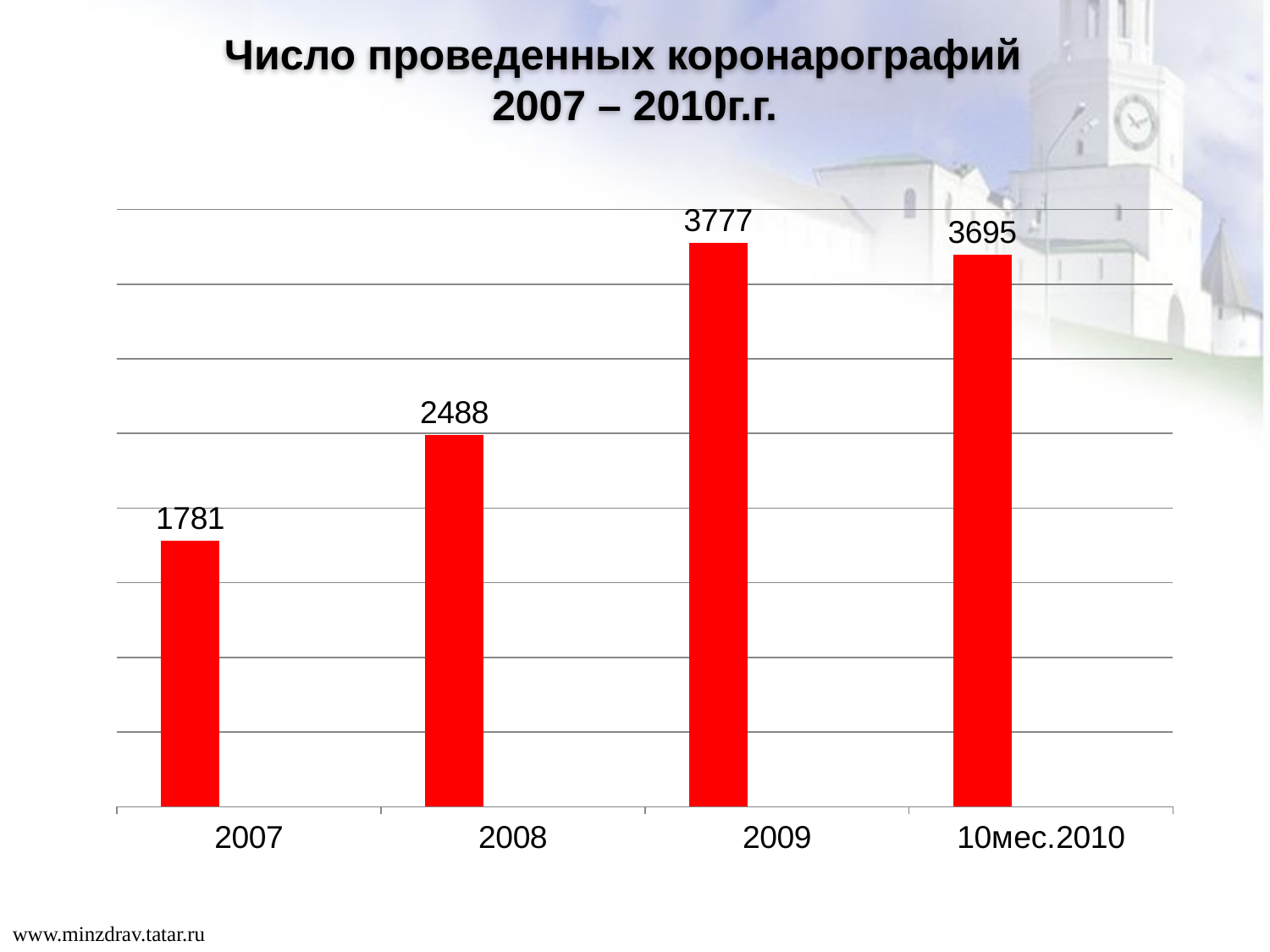
What is the value for 2009? 3777 What is the value for 10мес.2010? 3695 How many categories are shown on the x axis? 4 What is the difference between the values for 2009 and 2008? 1289 What is the title of the chart? Число проведенных коронарографий 2007 – 2010г.г. What kind of chart is this? bar chart What is the value for 2007? 1781 Which is larger, the value for 2009 or the value for 10мес.2010? 2009 What is the difference between the values for 2008 and 2007? 707 What is the value for 2008? 2488 Which category has the highest value? 2009 Which category has the lowest value? 2007